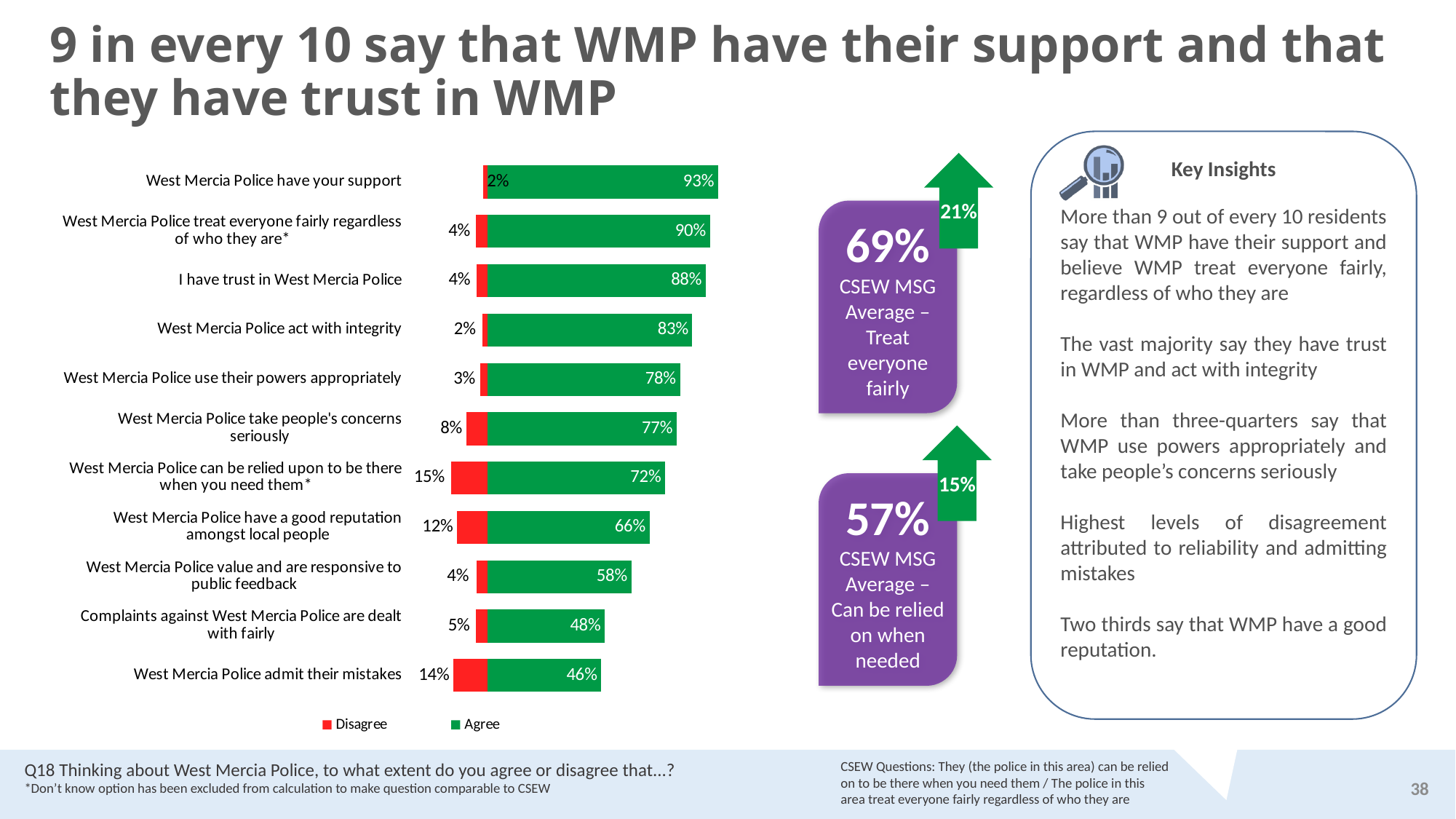
Which statement has the highest Agree percentage? West Mercia Police have your support What type of chart is shown on the slide? Bar chart What percentage disagree that West Mercia Police can be relied upon to be there when you need them? 15% What percentage agree that West Mercia Police have your support? 93% Which colour represents Disagree in the chart? Red Which statement has the lowest Agree percentage? West Mercia Police admit their mistakes Which statement has the highest Disagree percentage? West Mercia Police can be relied upon to be there when you need them What is the difference between the Agree percentage for 'I have trust in West Mercia Police' and 'West Mercia Police act with integrity'? 5% How many series does the chart legend list? 2 What percentage agree that West Mercia Police admit their mistakes? 46% Which has a higher Agree percentage: 'West Mercia Police have a good reputation amongst local people' or 'West Mercia Police value and are responsive to public feedback'? West Mercia Police have a good reputation amongst local people How many statements are shown in the chart? 11